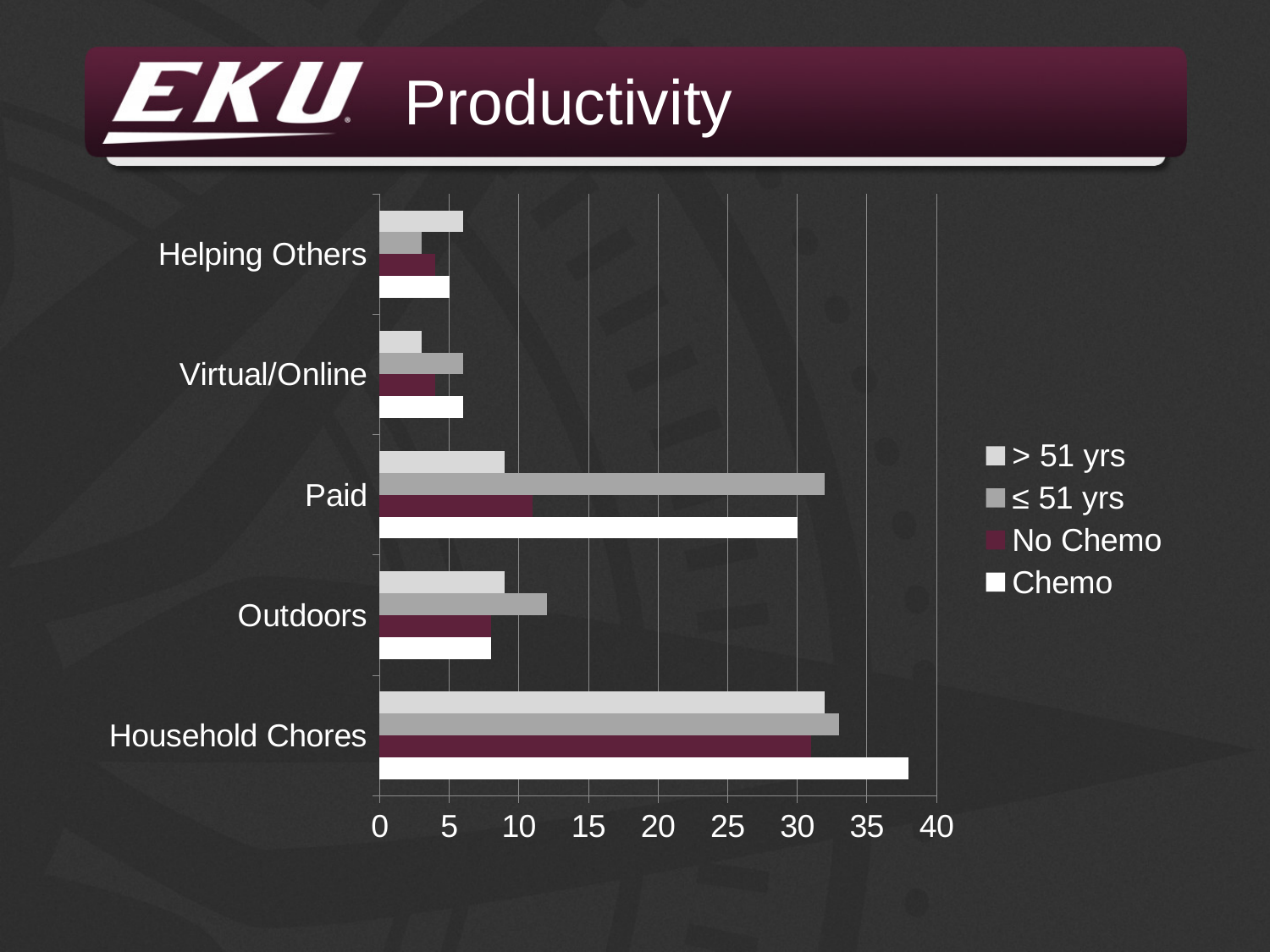
Which series has the highest value within the Household Chores category? Chemo What is the title of the slide containing the chart? Productivity How many series does the legend list? 4 Which series has the lowest value within the Paid category? > 51 yrs How many categories are shown on the vertical axis of the chart? 5 Which category has the highest value for the Chemo series? Household Chores What kind of chart is shown on the slide? bar chart Is the value for Chemo in Household Chores greater or less than 35? greater Which is larger for the Outdoors category: the ≤ 51 yrs value or the Chemo value? ≤ 51 yrs Which is larger for the Paid category: the Chemo value or the > 51 yrs value? Chemo Is the value for No Chemo in Paid greater or less than 15? less Is the value for ≤ 51 yrs in Paid greater or less than 30? greater